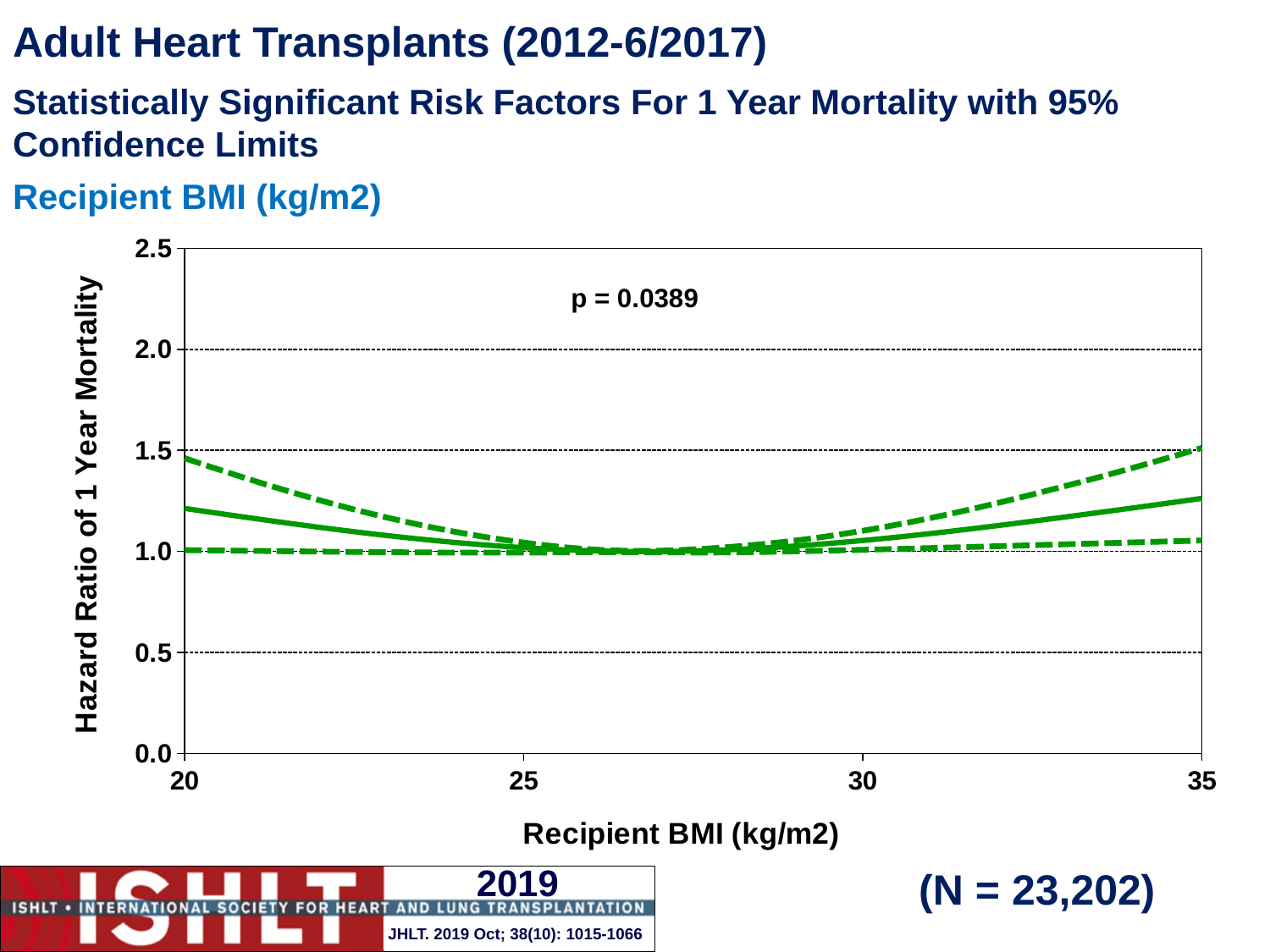
What is the sample size (N) shown on the slide? N = 23,202 What is the label of the y axis? Hazard Ratio of 1 Year Mortality Is the hazard ratio of the solid line at a recipient BMI of 20 greater or less than 1.5? less Is the hazard ratio of the solid line at a recipient BMI of 20 greater or less than 1.0? greater Is the upper dashed confidence limit at a recipient BMI of 20 greater or less than 1.5? less What is the p-value printed on the chart? p = 0.0389 What kind of chart is shown on the slide? line chart Does the solid hazard ratio line rise or fall as recipient BMI increases from 20 to 25? fall How many lines are plotted on the chart? 3 Does the solid hazard ratio line rise or fall as recipient BMI increases from 30 to 35? rise